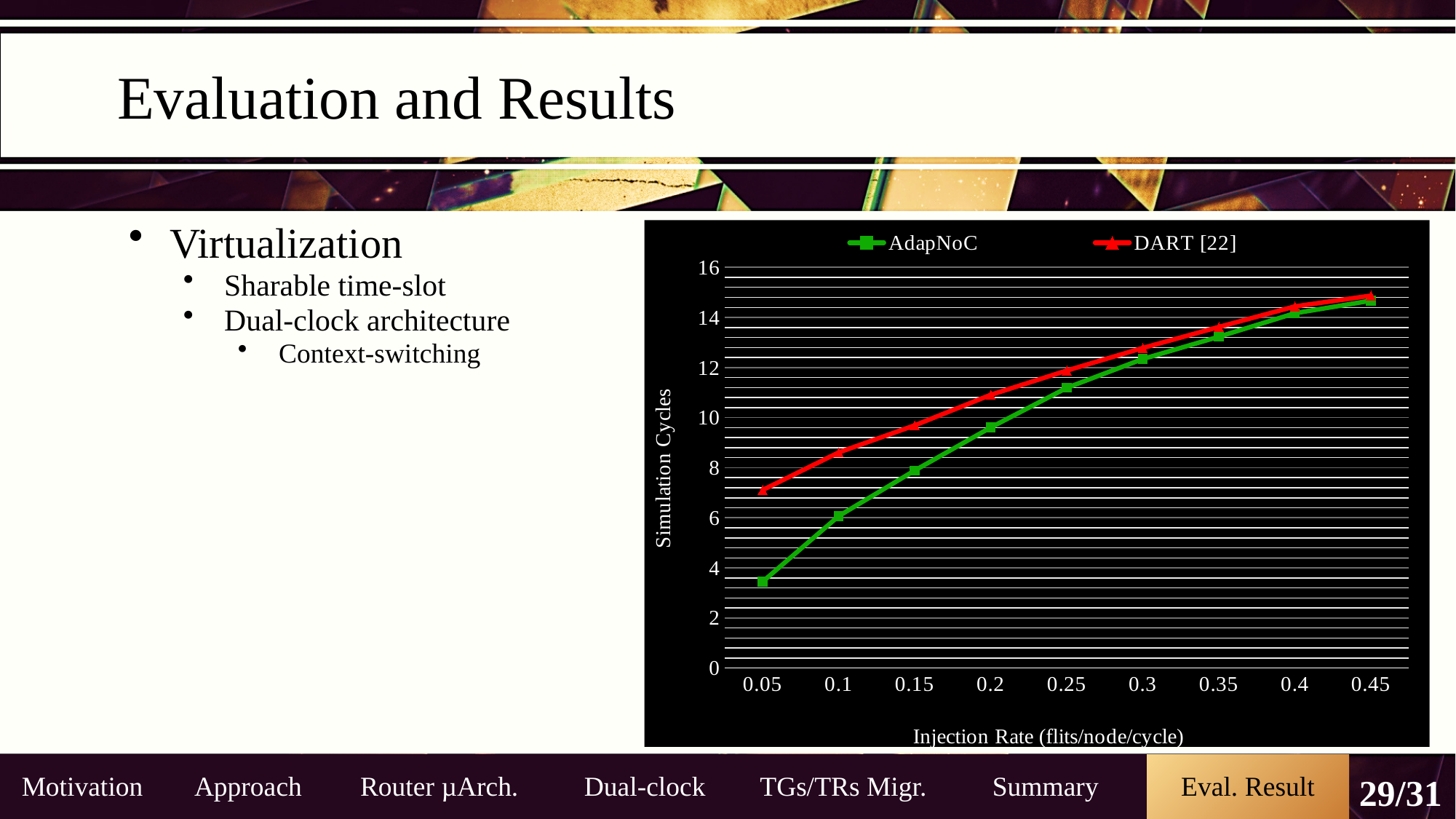
How many series does the chart legend list? 2 Is the value for DART [22] at injection rate 0.05 greater or less than 6? greater Is the value for DART [22] at injection rate 0.2 greater or less than 10? greater Do the simulation cycles for AdapNoC rise or fall as the injection rate increases? rise Is the value for AdapNoC at injection rate 0.2 greater or less than 10? less Do the simulation cycles for DART [22] rise or fall as the injection rate increases? rise How many injection rate values are plotted along the x axis? 9 What kind of chart is shown on the slide? line chart At injection rate 0.05, which series has the higher simulation cycles, AdapNoC or DART [22]? DART [22] What is the label of the x axis? Injection Rate (flits/node/cycle) What is the label of the y axis? Simulation Cycles